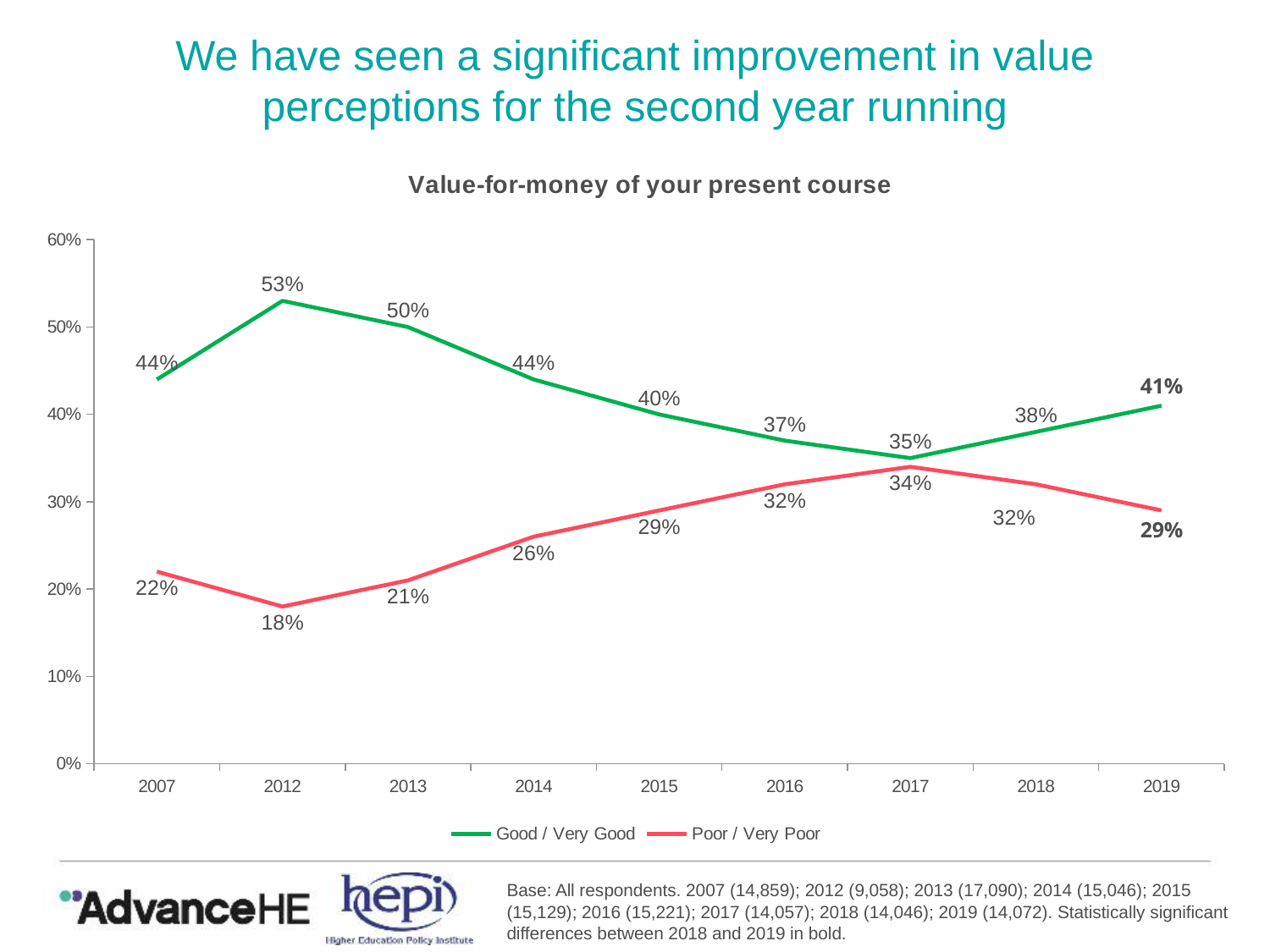
How many years are shown on the x axis? 9 What is the difference between the Good / Very Good and Poor / Very Poor values in 2019? 12% What kind of chart is shown? Line chart Which is larger in 2017: the Good / Very Good value or the Poor / Very Poor value? Good / Very Good What is the Good / Very Good value for 2019? 41% What is the Poor / Very Poor value for 2017? 34% In which year is the Good / Very Good series at its highest? 2012 How many series does the legend list? 2 In which year is the Poor / Very Poor series at its lowest? 2012 Does the Poor / Very Poor series rise or fall between 2012 and 2017? Rise What is the title of the chart? Value-for-money of your present course What is the Good / Very Good value for 2012? 53%